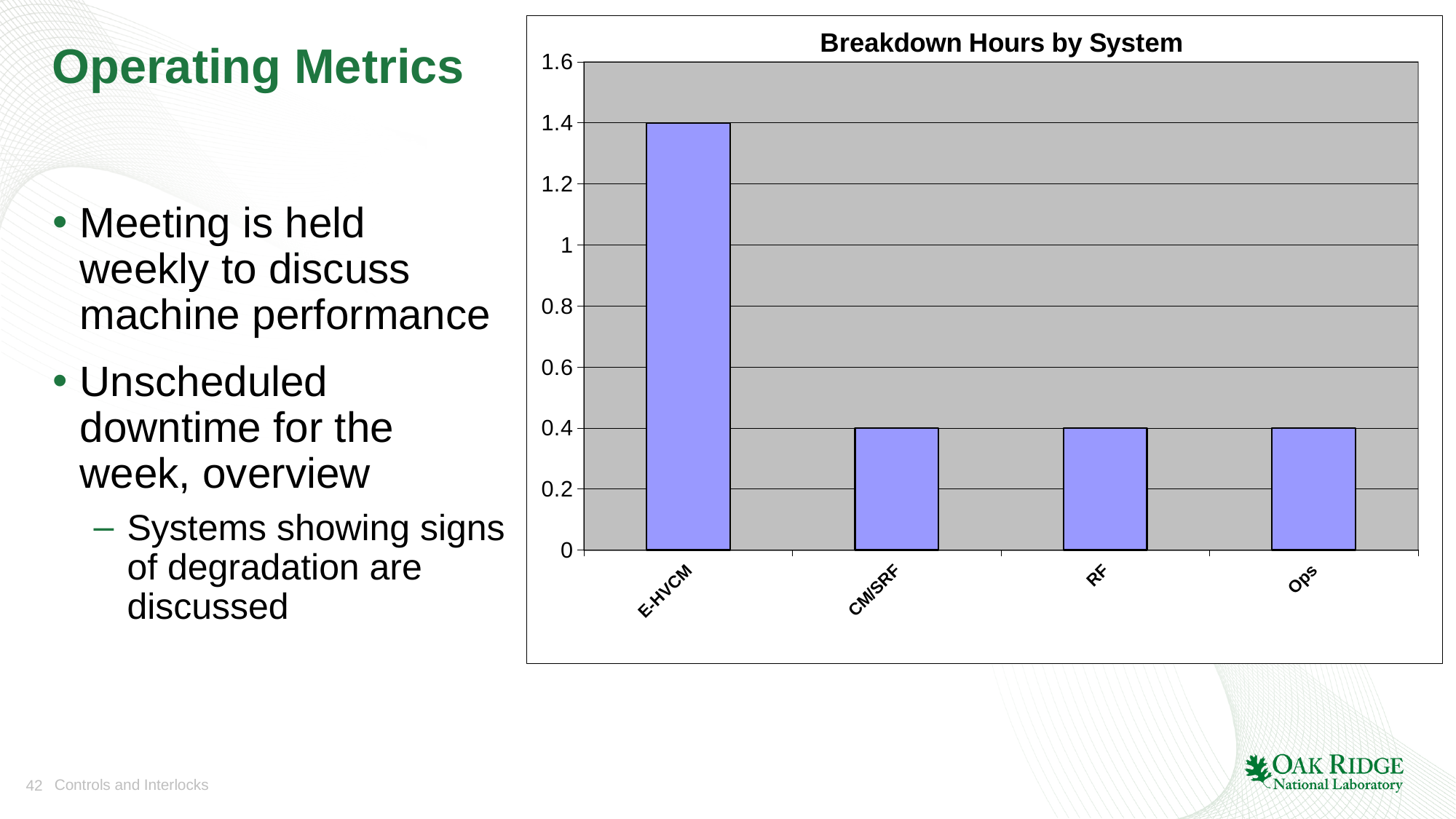
What is the maximum value shown on the y axis of the chart? 1.6 What is the difference between the values for E-HVCM and RF? 1 What kind of chart is shown on the slide? bar chart What is the value for CM/SRF? 0.4 Is the value for E-HVCM greater or less than 1? greater How many systems are shown on the x axis of the chart? 4 Is the value for RF greater or less than 0.6? less Which is larger, the value for E-HVCM or the value for CM/SRF? E-HVCM Which system has the highest breakdown hours? E-HVCM What is the value for E-HVCM? 1.4 What is the value for Ops? 0.4 What is the title of the chart? Breakdown Hours by System